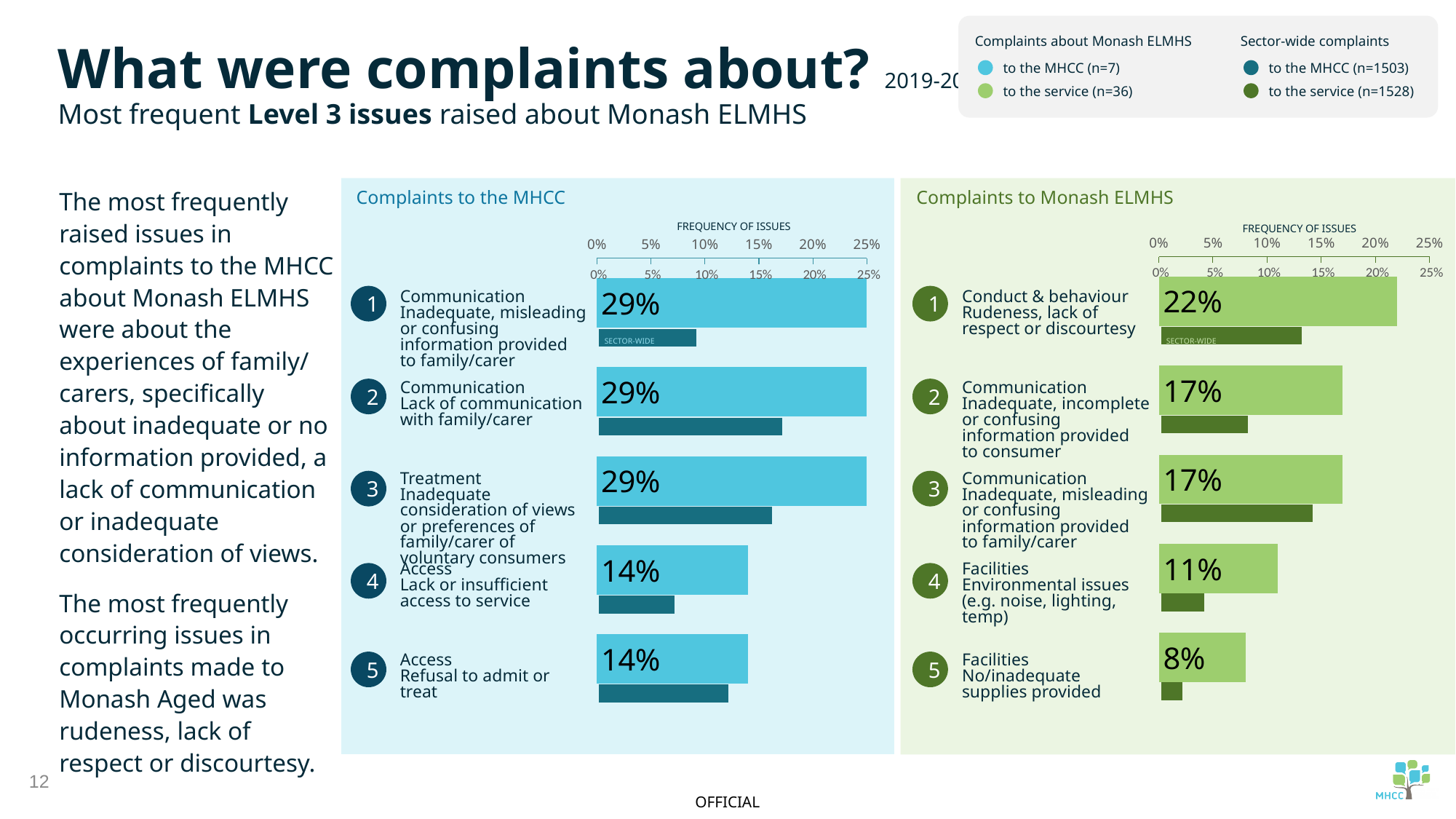
In the 'Complaints to Monash ELMHS' chart, what is the frequency for issue 1, Conduct & behaviour – Rudeness, lack of respect or discourtesy? 22% In the 'Complaints to the MHCC' chart, is the sector-wide value for issue 1 greater or less than 10%? less In the 'Complaints to Monash ELMHS' chart, is the sector-wide value for issue 4, Facilities – Environmental issues, greater or less than 5%? less In the 'Complaints to Monash ELMHS' chart, what is the frequency for issue 5, Facilities – No/inadequate supplies provided? 8% In the 'Complaints to the MHCC' chart, what is the difference between the frequency for issue 2 (29%) and issue 5 (14%)? 15% In the 'Complaints to the MHCC' chart, what is the frequency for issue 1, Communication – Inadequate, misleading or confusing information provided to family/carer? 29% In the 'Complaints to Monash ELMHS' chart, which issue has the highest frequency? Conduct & behaviour – Rudeness, lack of respect or discourtesy In the 'Complaints to the MHCC' chart, what is the frequency for issue 4, Access – Lack or insufficient access to service? 14% What kind of chart is used in the 'Complaints to Monash ELMHS' panel? Bar chart In the 'Complaints to Monash ELMHS' chart, what is the difference between the frequency for issue 1 (22%) and issue 4 (11%)? 11% How many issues are listed in the 'Complaints to the MHCC' chart? 5 In the 'Complaints to Monash ELMHS' chart, which issue has the lowest frequency? Facilities – No/inadequate supplies provided